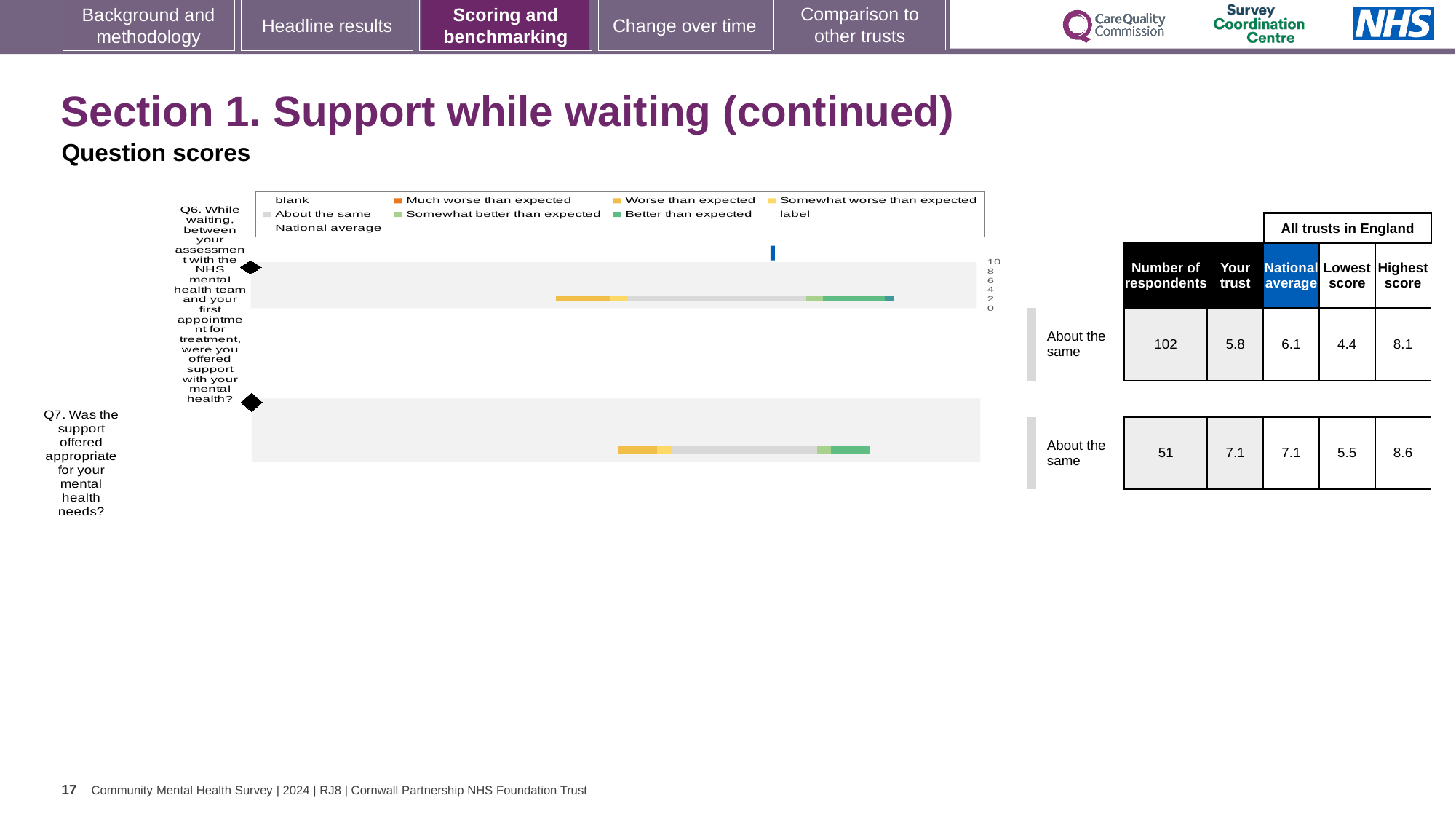
What is the 'Your trust' score for Q6? 5.8 How many questions (categories) are plotted in the chart? 2 What is the difference between the highest and lowest scores among all trusts in England for Q7? 3.1 What is the highest score among all trusts in England for Q7? 8.6 What is the national average score for Q7? 7.1 How many entries does the chart legend list? 9 How many respondents answered Q6? 102 Which is larger for Q6: the 'Your trust' score or the national average? National average What kind of chart is shown on the slide? bar chart What is the lowest score among all trusts in England for Q6? 4.4 What benchmark category is shown for Q7? About the same What is the difference between the national average and the 'Your trust' score for Q6? 0.3